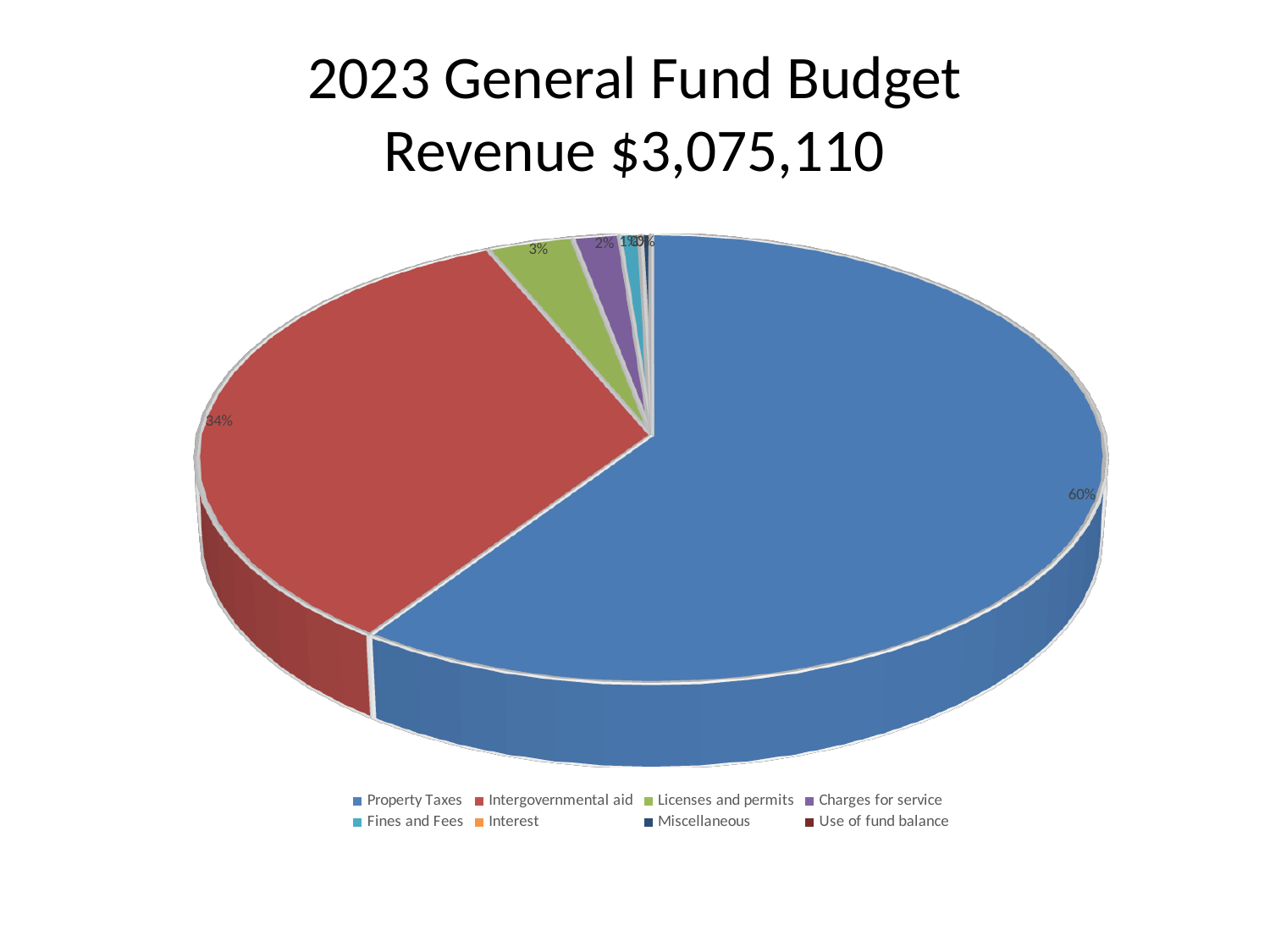
Which is larger, the Intergovernmental aid slice or the Licenses and permits slice? Intergovernmental aid What colour is the Property Taxes slice? Blue How many percentage points larger is the Property Taxes slice than the Intergovernmental aid slice? 26 percentage points Is the Property Taxes share greater or less than 50%? greater What kind of chart is shown on the slide? Pie chart What share of the pie does Property Taxes represent? 60% What percentage of the pie is Intergovernmental aid? 34% Which category has the largest slice of the pie? Property Taxes What percentage is shown for Charges for service? 2% How many categories does the legend list? 8 What is the title of the chart? 2023 General Fund Budget Revenue $3,075,110 What share of the pie is Licenses and permits? 3%